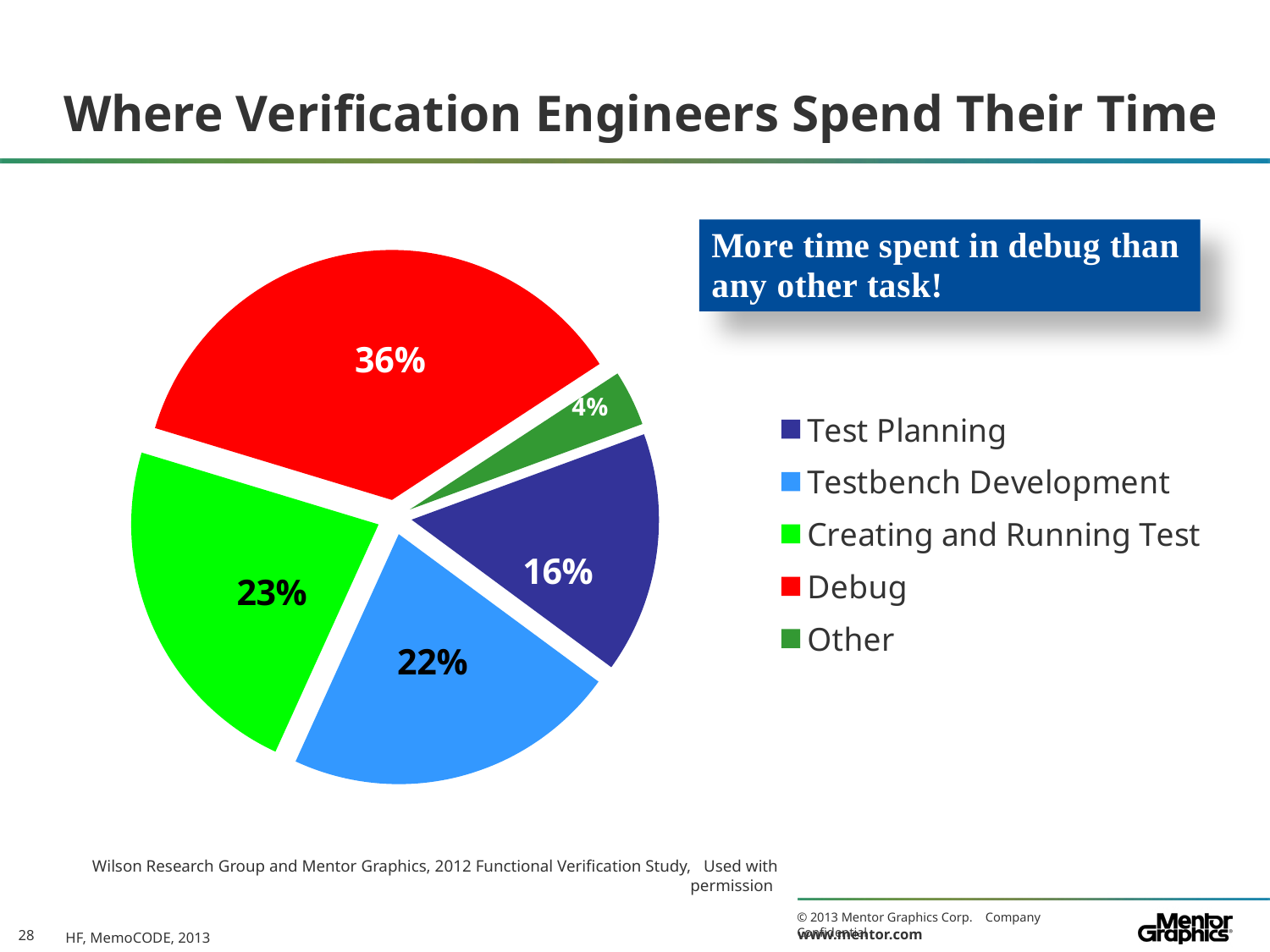
Which category has the smallest slice of the pie? Other How many percentage points larger is the Debug share than the Test Planning share? 20 What kind of chart is shown on the slide? pie chart What colour is the Debug slice in the pie chart? red What share of time is spent on Debug? 36% What share of time is spent on Creating and Running Test? 23% What share of time is spent on Test Planning? 16% How many categories does the pie chart have? 5 What share of time is spent on Other? 4% Which task takes the largest share of verification engineers' time? Debug Which is larger, the share for Debug or the share for Testbench Development? Debug What share of time is spent on Testbench Development? 22%